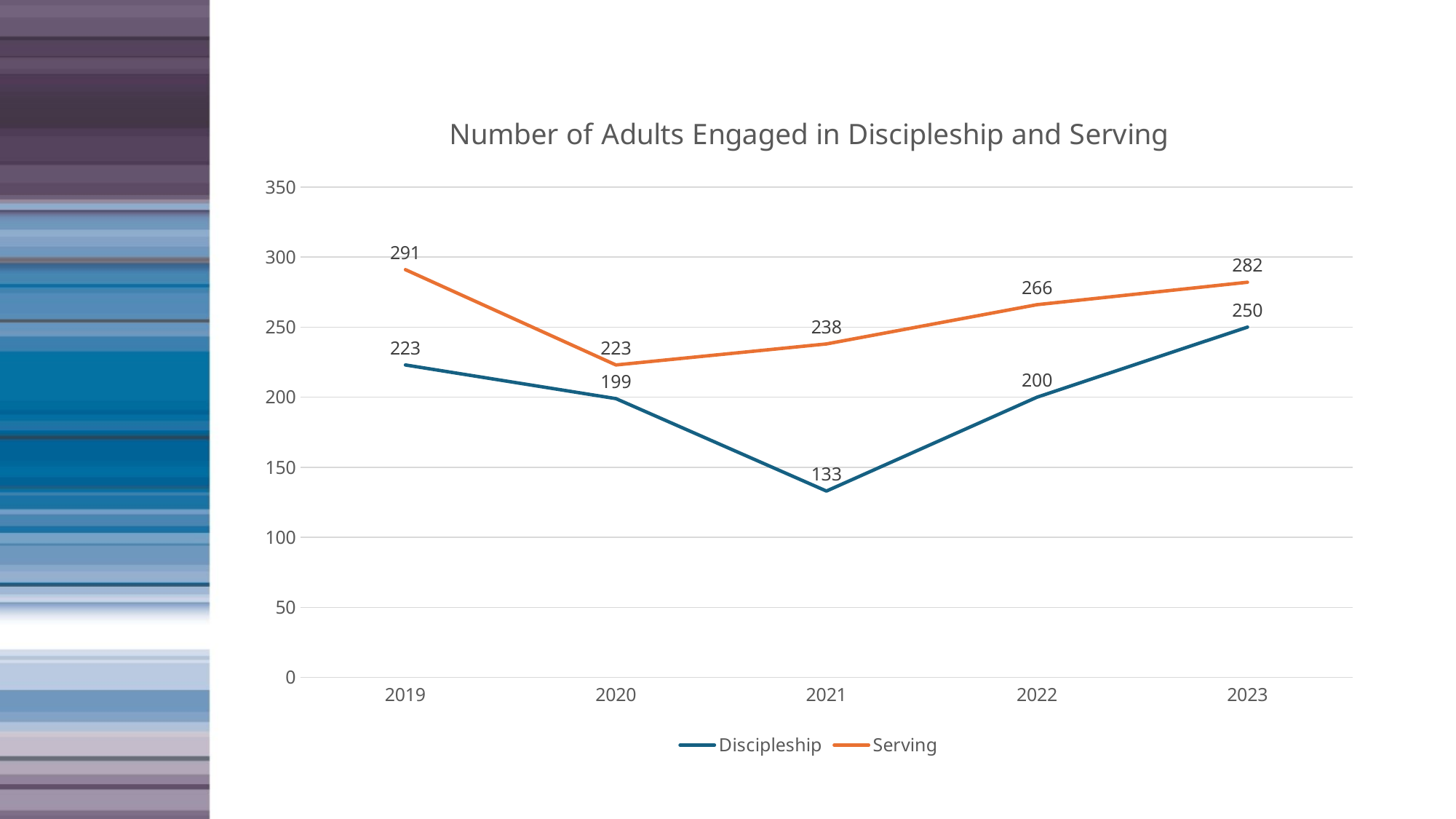
In which year is the Serving value highest? 2019 What is the Discipleship value for 2023? 250 How many series does the legend list? 2 What is the Serving value for 2019? 291 What kind of chart is shown? Line chart How many years are shown on the x axis? 5 What is the title of the chart? Number of Adults Engaged in Discipleship and Serving Which is larger in 2020, the Serving value or the Discipleship value? Serving Does the Discipleship line rise or fall from 2021 to 2023? Rise What is the difference between the Serving and Discipleship values in 2021? 105 What is the Discipleship value for 2021? 133 In which year is the Discipleship value lowest? 2021